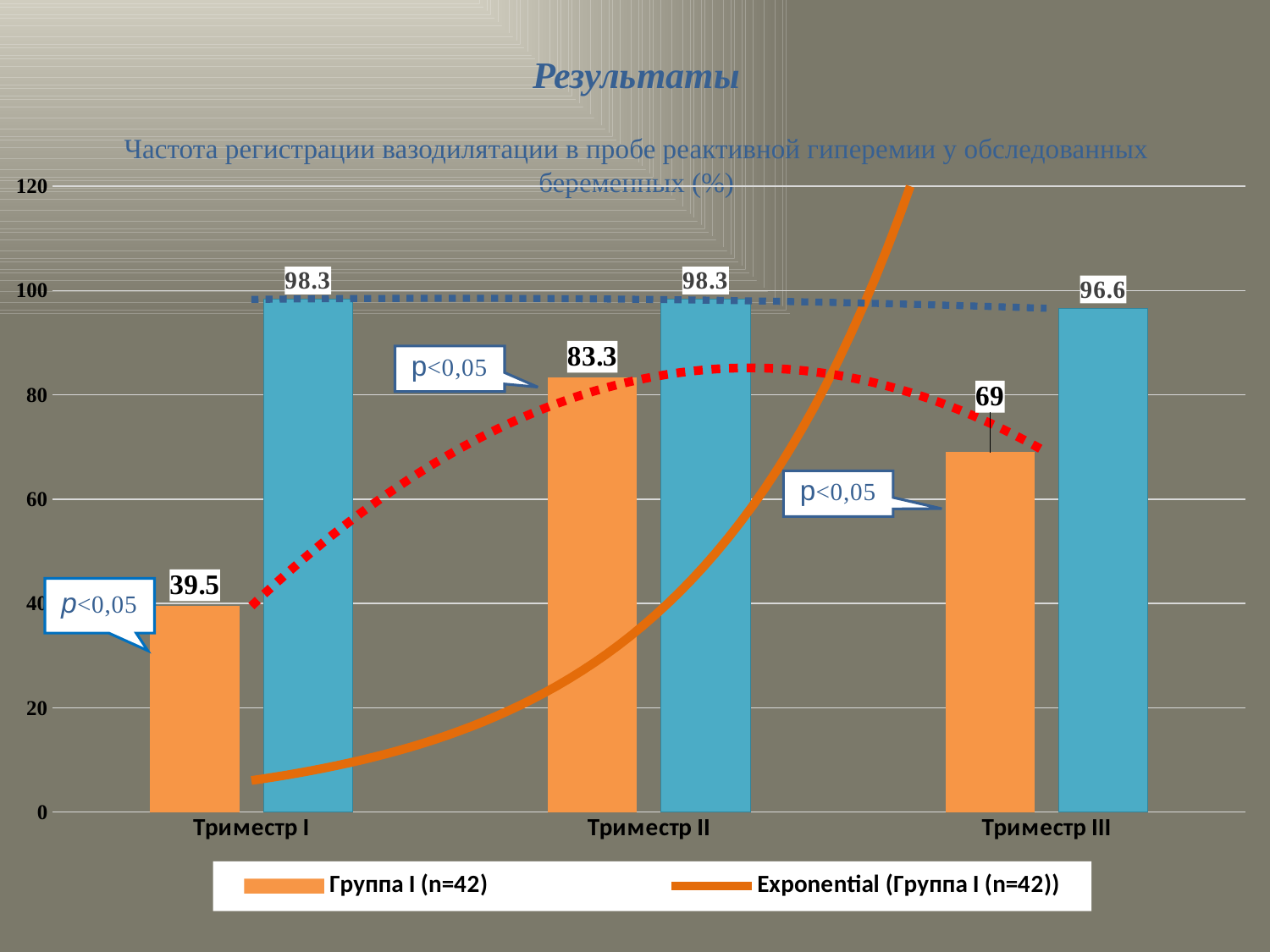
What kind of chart is shown on the slide? bar chart Which is larger for Триместр II: the Группа I (n=42) bar or the blue bar? the blue bar In which trimester is the Группа I (n=42) bar highest? Триместр II What is the difference between the blue bar and the Группа I (n=42) bar for Триместр I? 58.8 How many entries does the legend list? 2 What is the difference between the Группа I (n=42) values for Триместр II and Триместр III? 14.3 How many trimester categories are shown on the x axis? 3 What is the value of the Группа I (n=42) bar for Триместр II? 83.3 In which trimester is the Группа I (n=42) bar lowest? Триместр I What is the value of the Группа I (n=42) bar for Триместр I? 39.5 What is the value of the Группа I (n=42) bar for Триместр III? 69 What is the value of the blue bar for Триместр III? 96.6